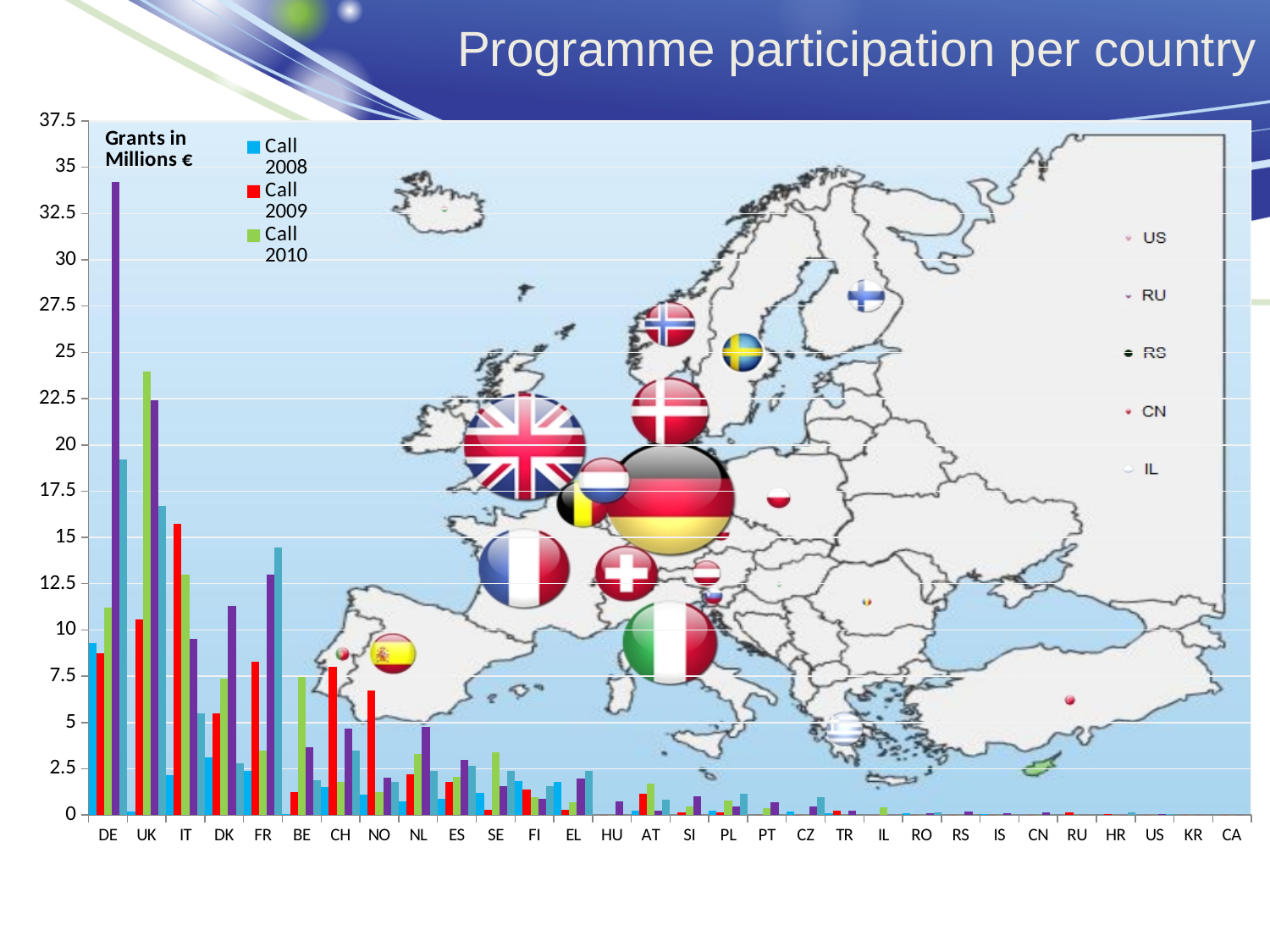
What kind of chart is shown on the slide? bar chart How many countries are shown on the x axis of the chart? 30 Which country has the highest Call 2009 value? IT Do the bar heights generally rise or fall moving from DE on the left to CA on the right? fall Is the Call 2009 value for IT greater or less than 12.5? greater Which country has the tallest bar in the chart? DE What unit is given for the values on the chart's y axis? Grants in Millions € Is the Call 2010 value for UK greater or less than 20? greater Is the tallest bar for DE greater or less than 30? greater How many series does the chart's legend list? 3 What is the title of the slide's chart? Programme participation per country Which country has the highest Call 2010 value? UK